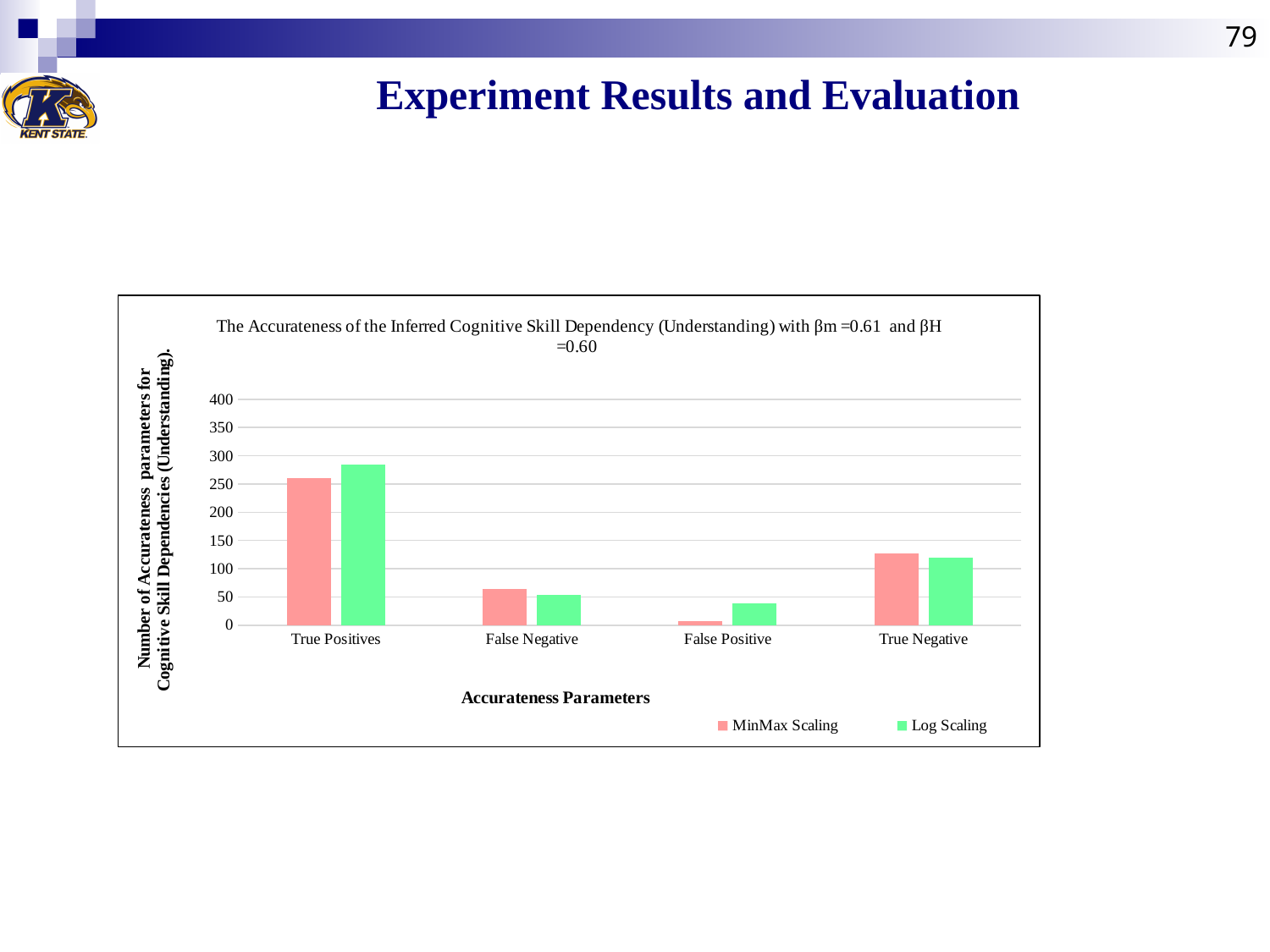
How many categories are shown on the x axis of the chart? 4 Is the value for True Negative under MinMax Scaling greater or less than 100? greater For False Positive, which series has the larger value, MinMax Scaling or Log Scaling? Log Scaling Which category has the highest value for Log Scaling? True Positives Which category has the lowest value for MinMax Scaling? False Positive What are the two series named in the chart's legend? MinMax Scaling and Log Scaling For True Positives, which series has the larger value, MinMax Scaling or Log Scaling? Log Scaling Which category has the highest value for MinMax Scaling? True Positives Is the value for True Positives under Log Scaling greater or less than 250? greater What kind of chart is shown on the slide? bar chart Which category has the lowest value for Log Scaling? False Positive How many series does the chart's legend list? 2